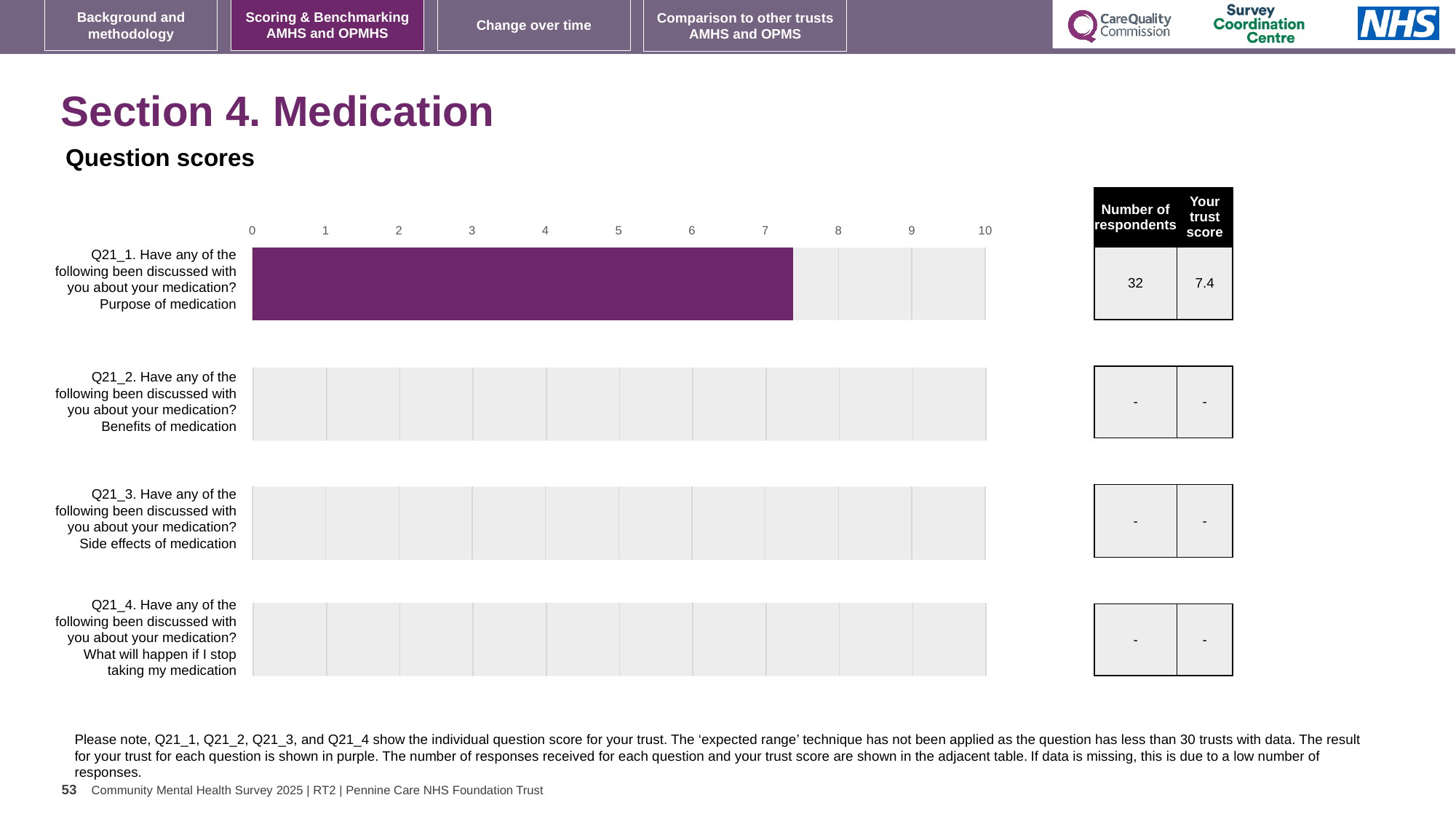
What is the maximum value shown on the chart's axis? 10 What is shown as the number of respondents for Q21_4 (What will happen if I stop taking my medication)? - Which question is the only one with a plotted bar on the chart? Q21_1. Purpose of medication What colour is the bar for Q21_1? purple Is the bar for Q21_1 (Purpose of medication) greater or less than 8? less How many questions are listed on the chart? 4 What is the trust score for Q21_1 (Purpose of medication)? 7.4 How many respondents answered Q21_1 (Purpose of medication)? 32 How many of the four questions have no data shown (a dash in the table)? 3 What is shown as the trust score for Q21_3 (Side effects of medication) in the table? - What kind of chart is shown on the slide? bar chart Is the bar for Q21_1 (Purpose of medication) greater or less than 7? greater